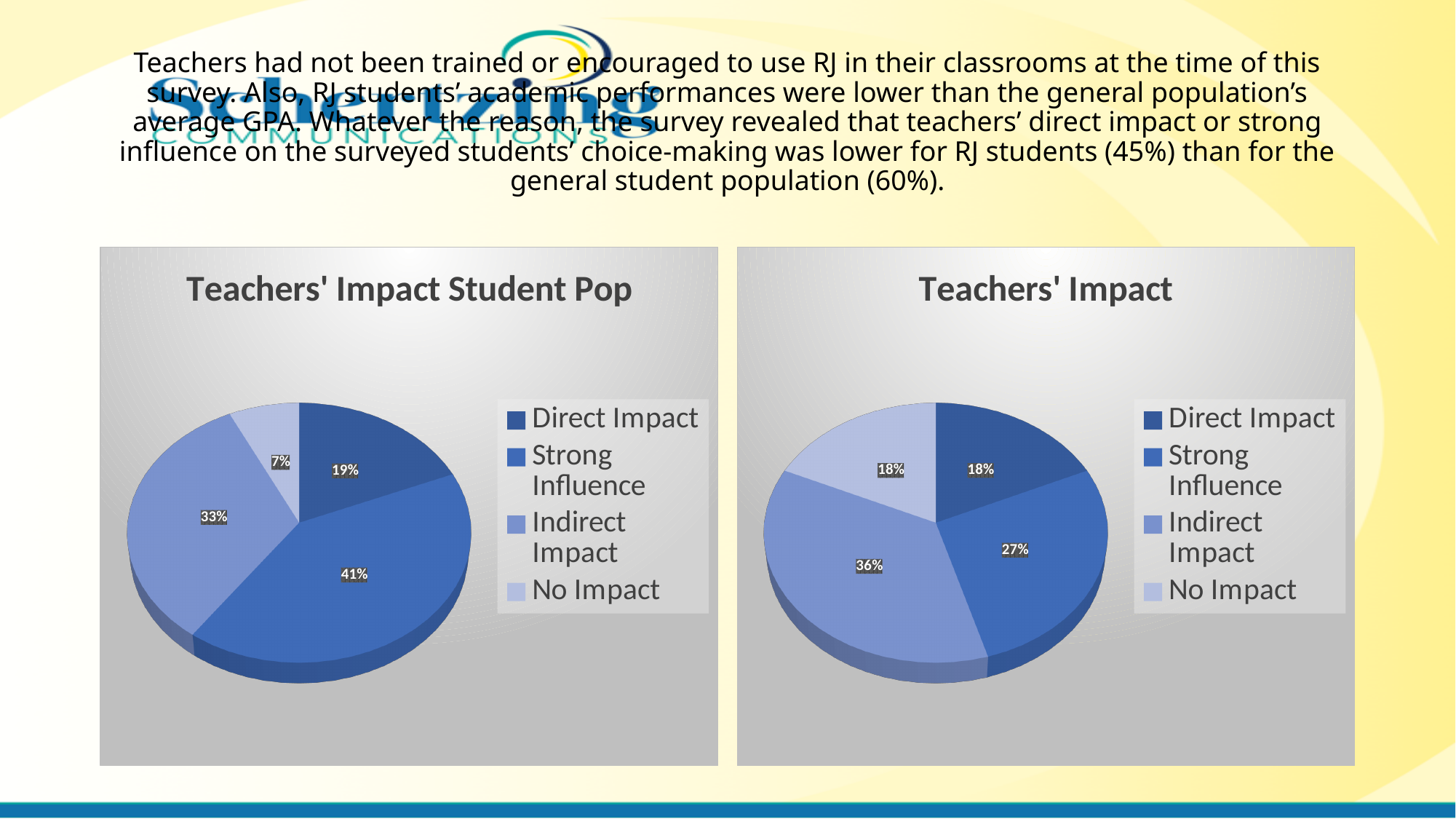
In the 'Teachers' Impact Student Pop' chart, what percentage is shown for No Impact? 7% In the 'Teachers' Impact' chart, which category has the largest slice? Indirect Impact In the 'Teachers' Impact Student Pop' chart, which category has the smallest slice? No Impact In the 'Teachers' Impact' chart, is the Indirect Impact slice larger or smaller than the Strong Influence slice? larger In the 'Teachers' Impact Student Pop' chart, what percentage is shown for Strong Influence? 41% In the 'Teachers' Impact' chart, what percentage is shown for Indirect Impact? 36% What is the title of the chart on the right side of the slide? Teachers' Impact In the 'Teachers' Impact Student Pop' chart, which category has the largest slice? Strong Influence In the 'Teachers' Impact' chart, what percentage is shown for Strong Influence? 27% What type of chart is the 'Teachers' Impact Student Pop' chart? pie chart How many categories does the legend of the 'Teachers' Impact' chart list? 4 In the 'Teachers' Impact Student Pop' chart, what is the difference between the Strong Influence and Indirect Impact percentages? 8%